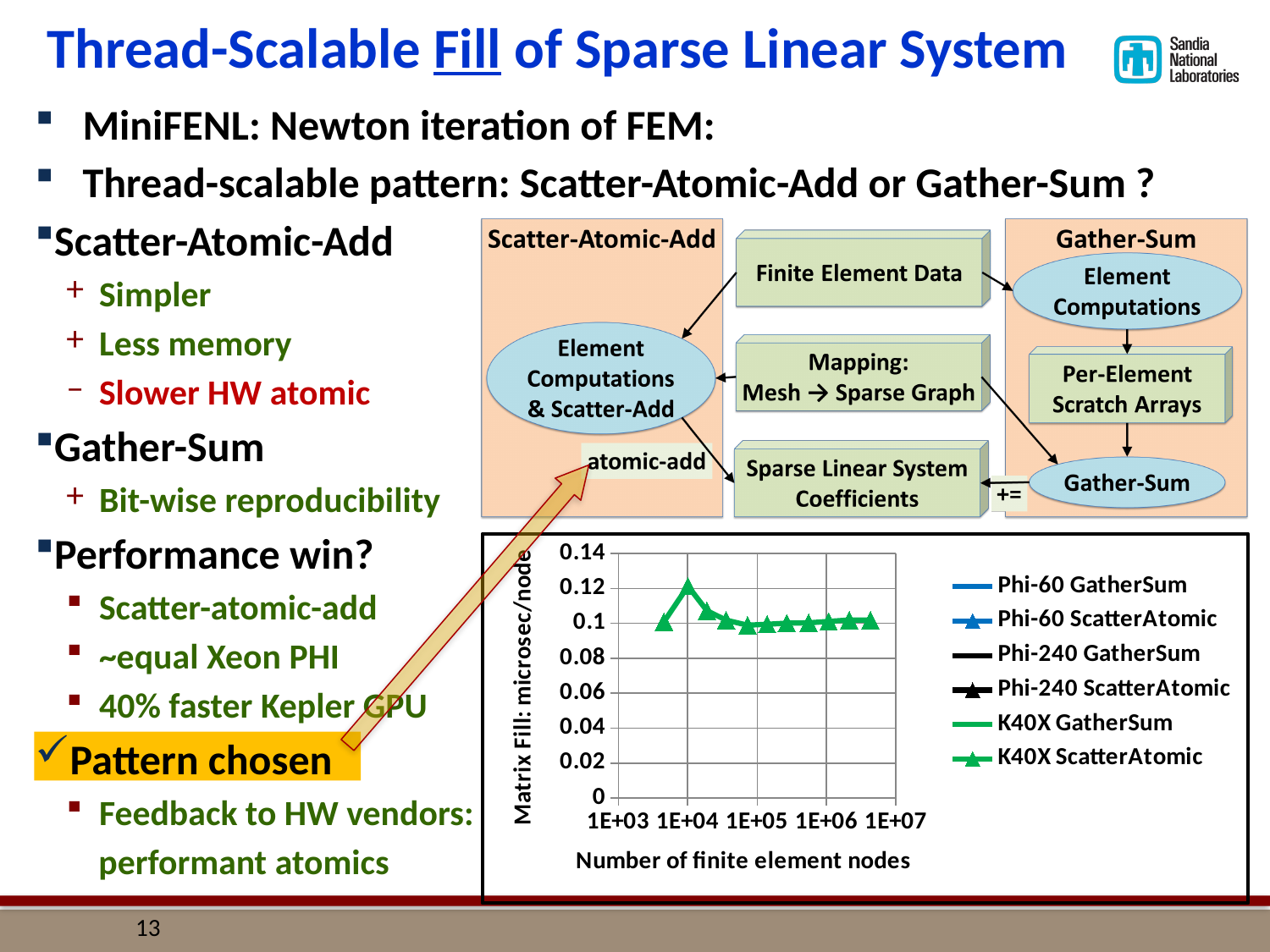
At which number of finite element nodes does the K40X ScatterAtomic line reach its highest value? 1E+04 How many series does the chart's legend list? 6 What kind of chart is shown on the slide? line chart Is the peak value of the K40X ScatterAtomic line greater or less than 0.1? greater Between 1E+03 and 1E+04 nodes, does the K40X ScatterAtomic line rise or fall? rise What is the highest value shown on the chart's vertical axis? 0.14 Is the K40X ScatterAtomic value at 1E+06 nodes greater or less than 0.12? less What is the label of the chart's vertical axis? Matrix Fill: microsec/node How many legend entries are GatherSum series? 3 What is the label of the chart's horizontal axis? Number of finite element nodes Between 1E+04 and 1E+05 nodes, does the K40X ScatterAtomic line rise or fall? fall